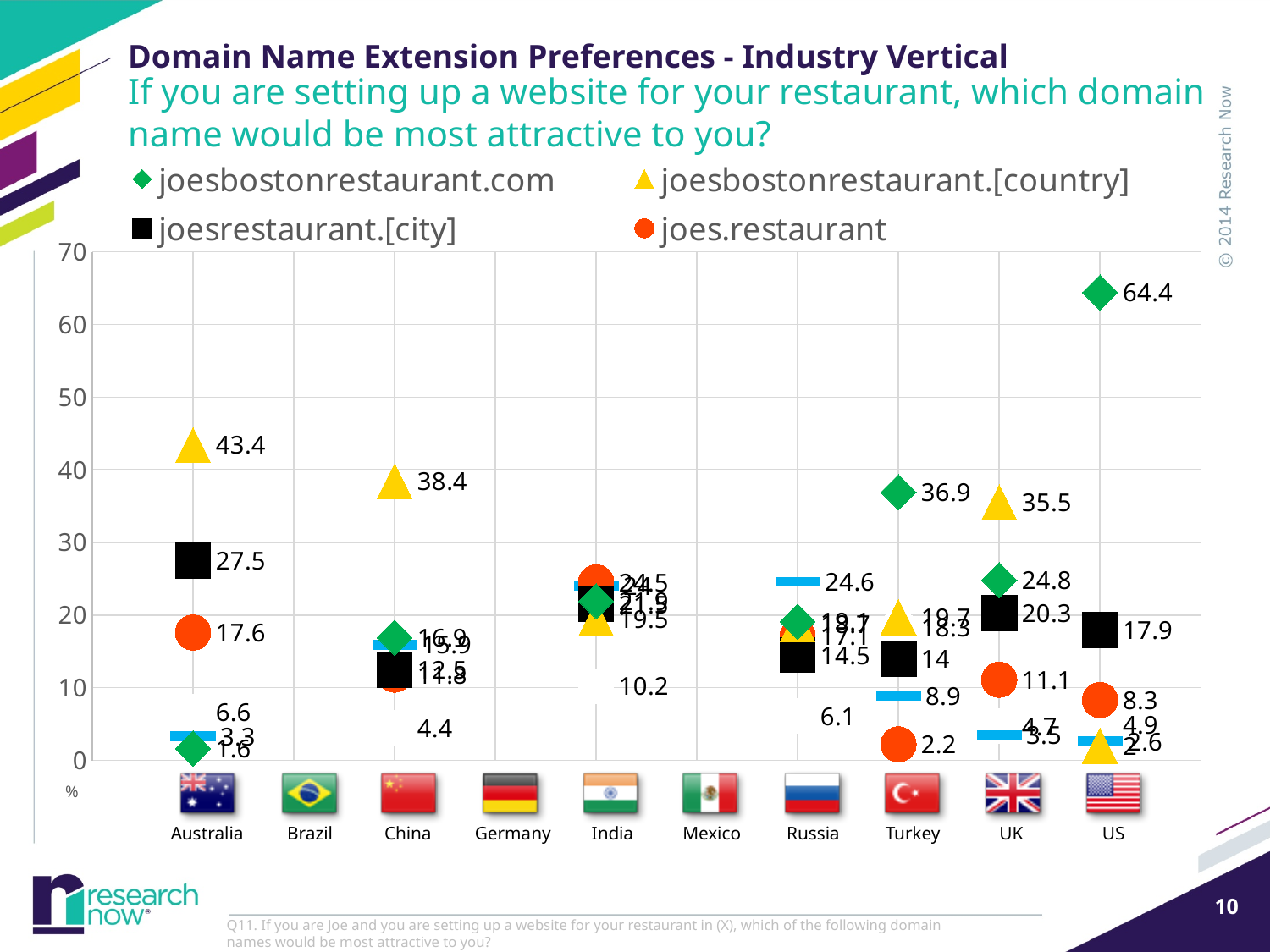
How many countries are shown on the x axis? 10 What is the difference between the joesbostonrestaurant.com values for the US and the UK? 39.6 What is the value for joesbostonrestaurant.[country] in China? 38.4 Which country has the highest value for joesbostonrestaurant.com? US What is the value for joesrestaurant.[city] in the UK? 20.3 What is the value for joesbostonrestaurant.[country] in Australia? 43.4 What is the value for joes.restaurant in Turkey? 2.2 Which country has the highest value for joesbostonrestaurant.[country]? Australia How many series does the legend list? 4 Which is larger: joesbostonrestaurant.[country] in Australia or in China? Australia What is the value for joesbostonrestaurant.com in the US? 64.4 What marker shape represents joes.restaurant in the legend? Orange circle